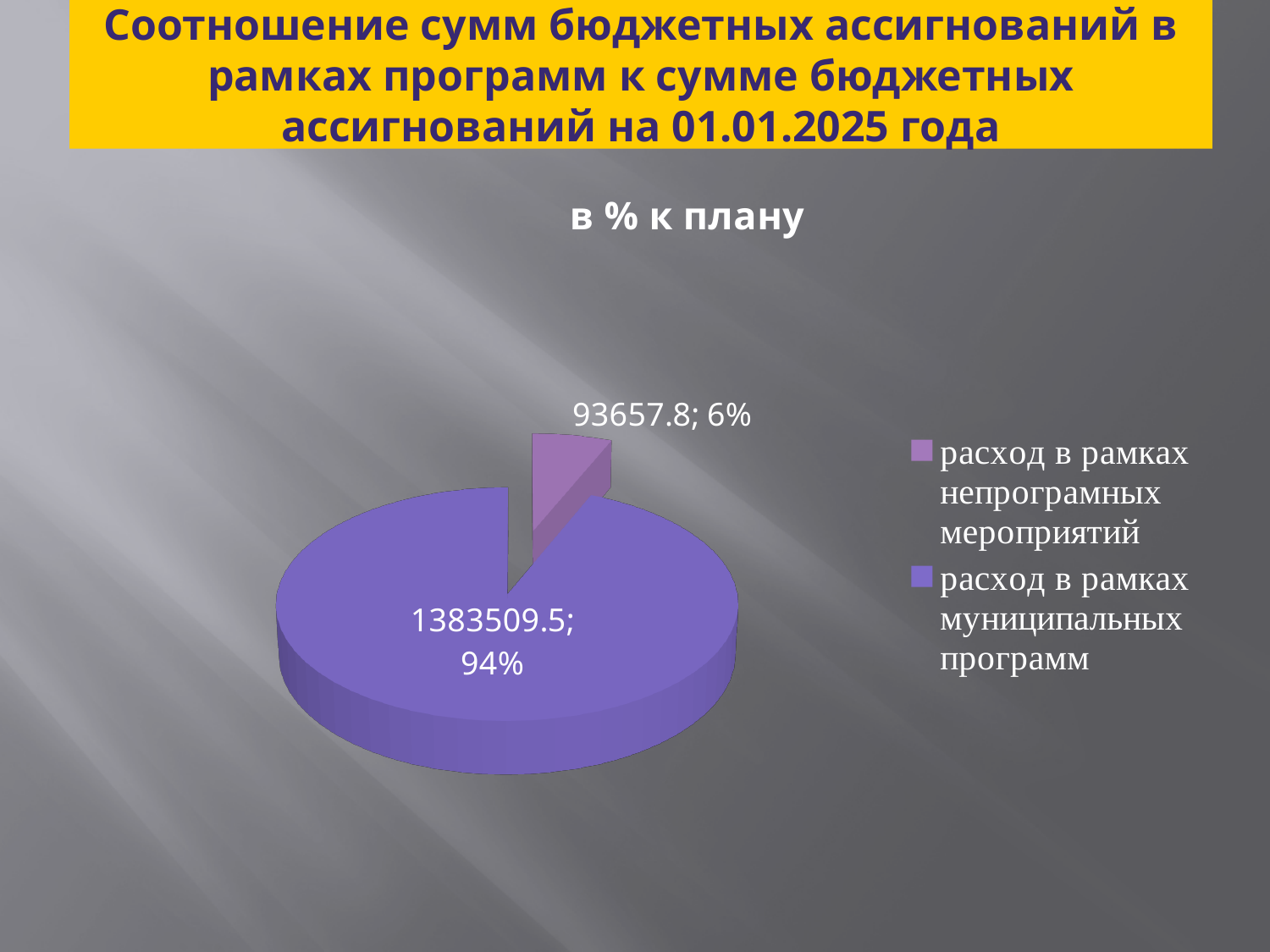
What value is shown for 'расход в рамках непрограмных мероприятий'? 93657.8 What is the chart's title? в % к плану Which is larger: the value for 'расход в рамках непрограмных мероприятий' or for 'расход в рамках муниципальных программ'? расход в рамках муниципальных программ Which category has the smallest slice? расход в рамках непрограмных мероприятий How many entries does the legend list? 2 Which category has the largest slice? расход в рамках муниципальных программ What is the difference between the values for 'расход в рамках муниципальных программ' and 'расход в рамках непрограмных мероприятий'? 1289851.7 How many slices does the pie chart have? 2 What kind of chart is shown on the slide? pie chart What value is shown for 'расход в рамках муниципальных программ'? 1383509.5 What share of the pie does 'расход в рамках муниципальных программ' take? 94% What share of the pie does 'расход в рамках непрограмных мероприятий' take? 6%